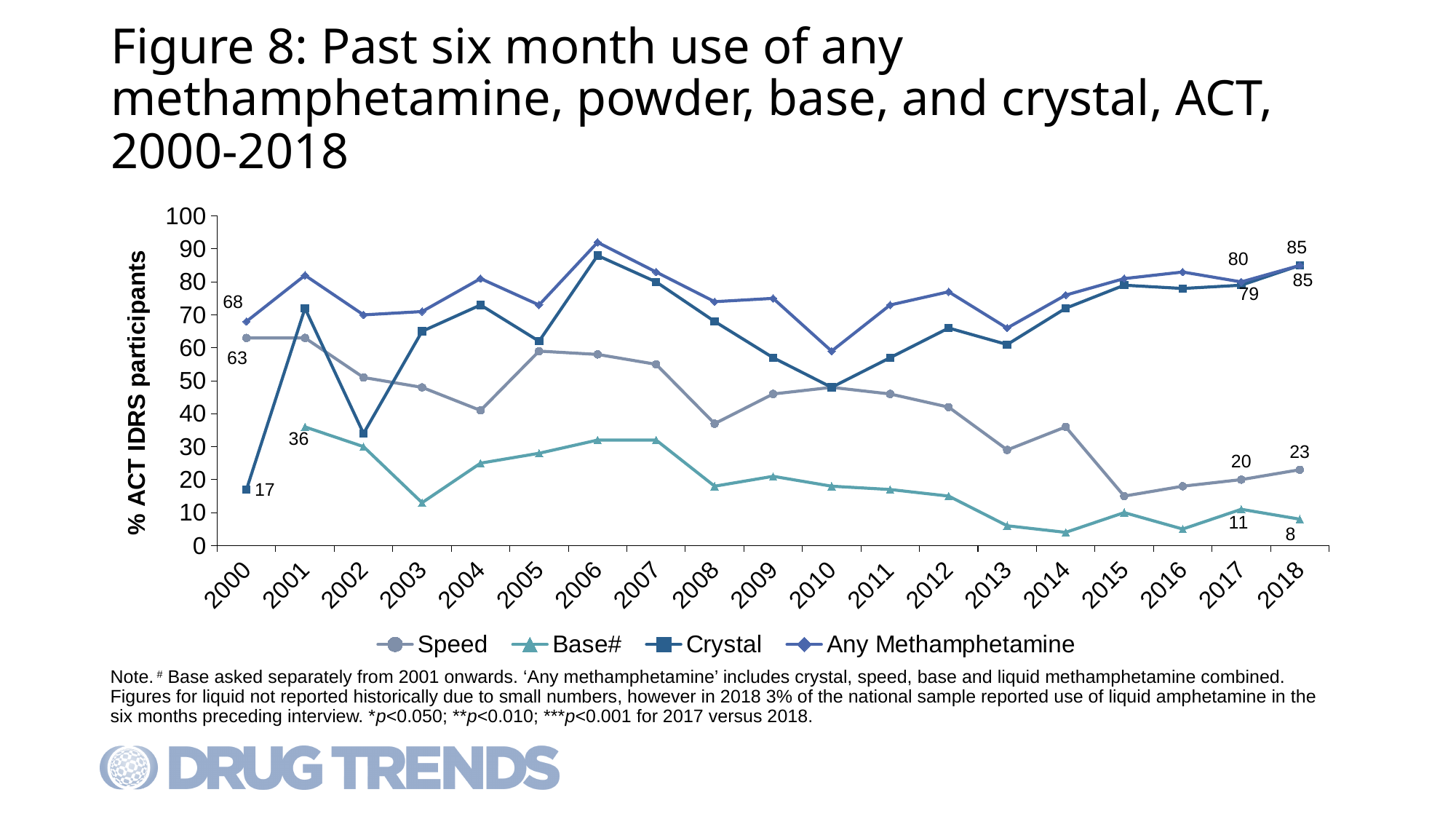
What was the value for Base# in 2001? 36 What was the value for Speed in 2018? 23 What is the difference between the Crystal value in 2018 and in 2000? 68 In 2018, which was higher: Speed or Base#? Speed What was the percentage of ACT IDRS participants reporting Crystal use in 2000? 17 Did the Speed series rise or fall from 2015 to 2018? rise How many series does the legend list? 4 Is the value for Base# in 2014 greater or less than 10? less By how many percentage points did Speed change from 2017 to 2018? 3 What was the value for Any Methamphetamine in 2017? 80 How many years are shown on the x axis? 19 What kind of chart is shown on the slide? line chart